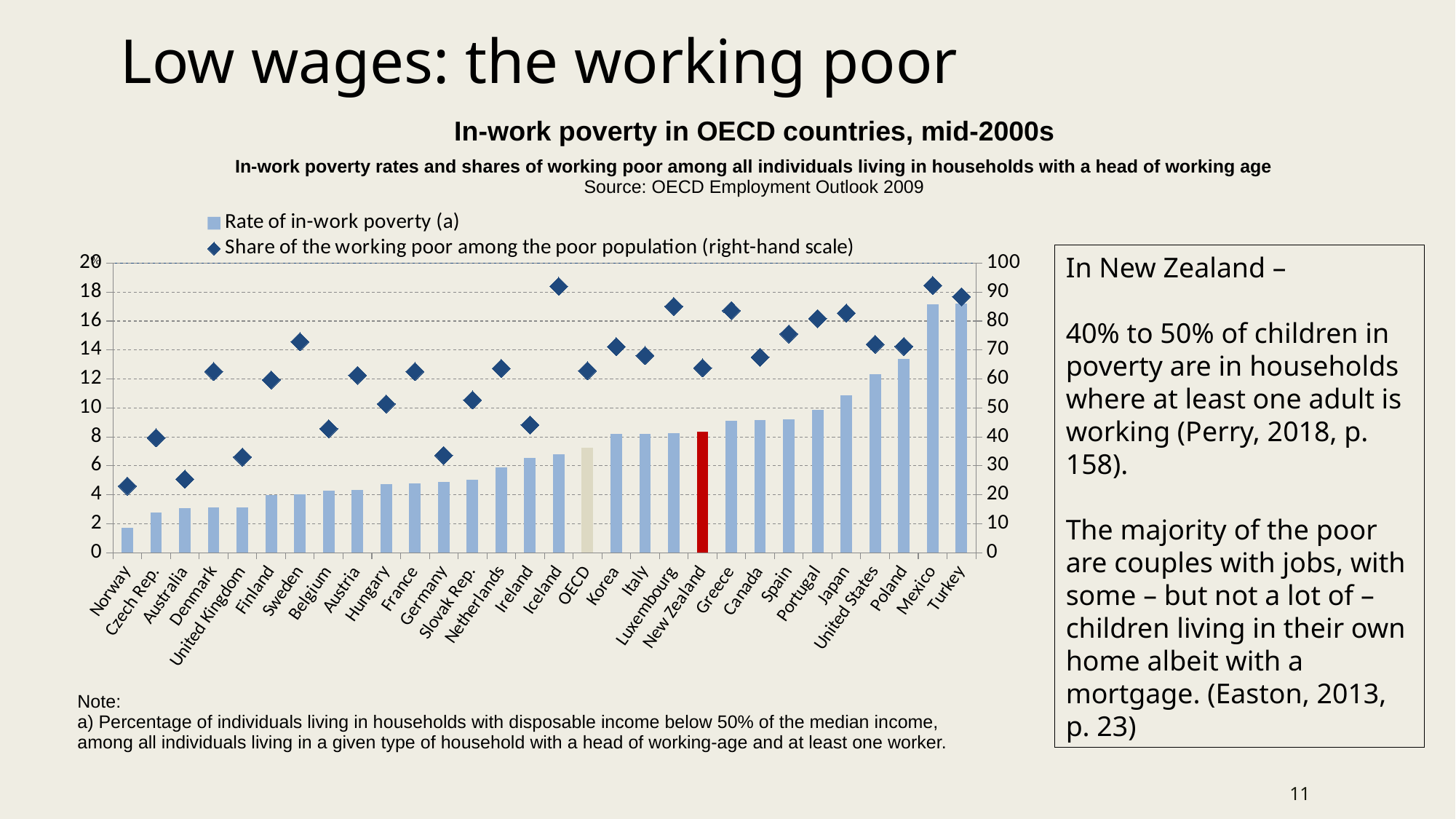
Do the rate of in-work poverty bars generally rise or fall from left to right across the x axis? rise What colour is the bar for New Zealand? red Which country has the lowest rate of in-work poverty (shortest bar)? Norway Which has the higher rate of in-work poverty bar, Japan or Korea? Japan How many countries or categories are shown on the x axis of the chart? 30 How many series does the chart legend list? 2 Is the share of the working poor among the poor population for Germany greater or less than 40 on the right-hand scale? less What is the title of the chart? In-work poverty in OECD countries, mid-2000s Is the rate of in-work poverty bar for Japan greater or less than 10? greater Is the rate of in-work poverty bar for Mexico greater or less than 16? greater